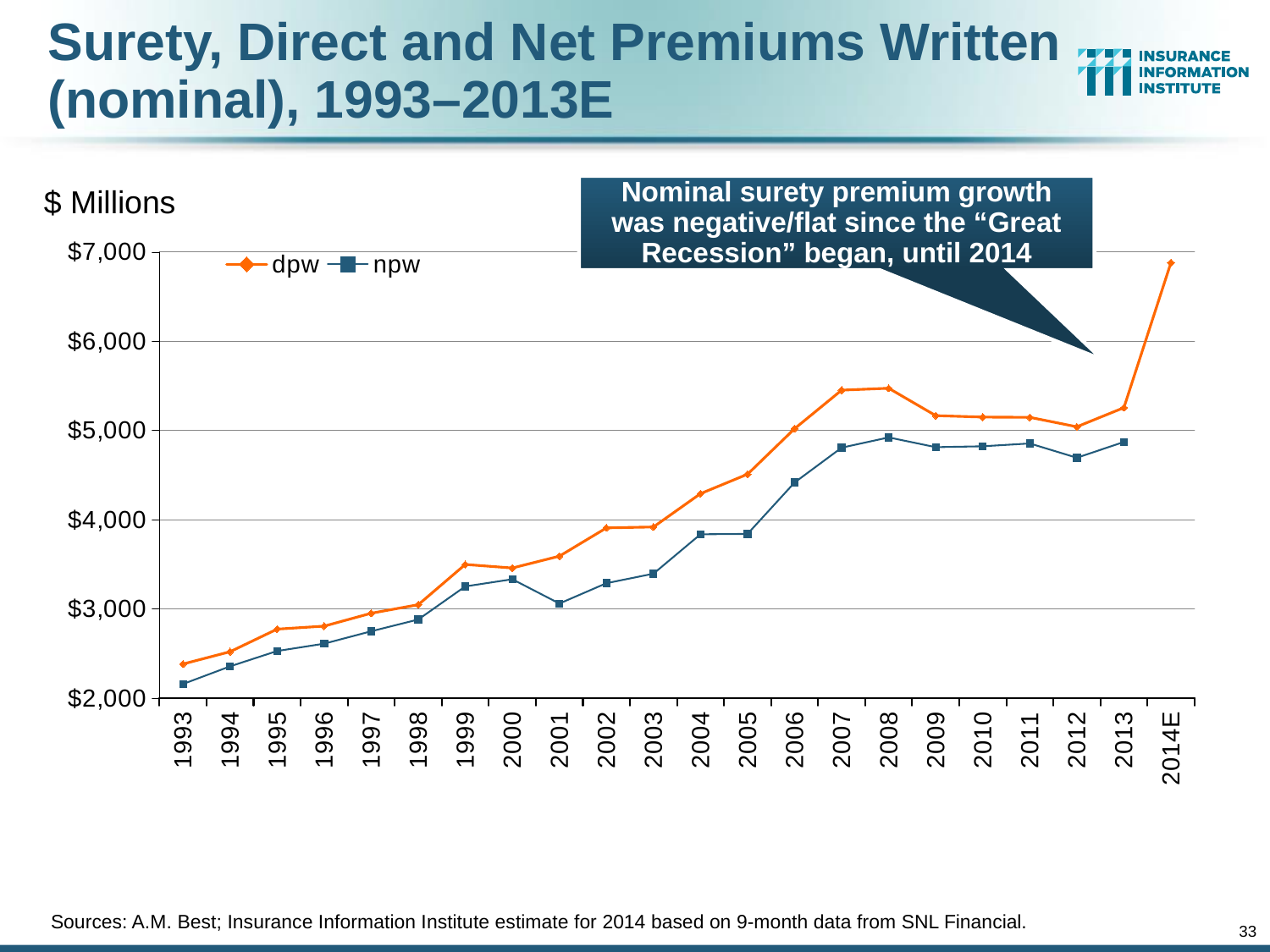
How many years are shown along the x axis? 22 Is the dpw value for 2014E greater or less than $6,000? greater In which year is the npw series at its lowest? 1993 In which year is the dpw series at its lowest? 1993 What kind of chart is shown on the slide? line chart Is the npw value for 1993 greater or less than $3,000? less How many series does the legend list? 2 What unit is indicated for the values on the y axis? $ Millions Is the npw value for 2012 greater or less than $5,000? less In 2007, which series has the larger value, dpw or npw? dpw In which year is the dpw series at its highest? 2014E